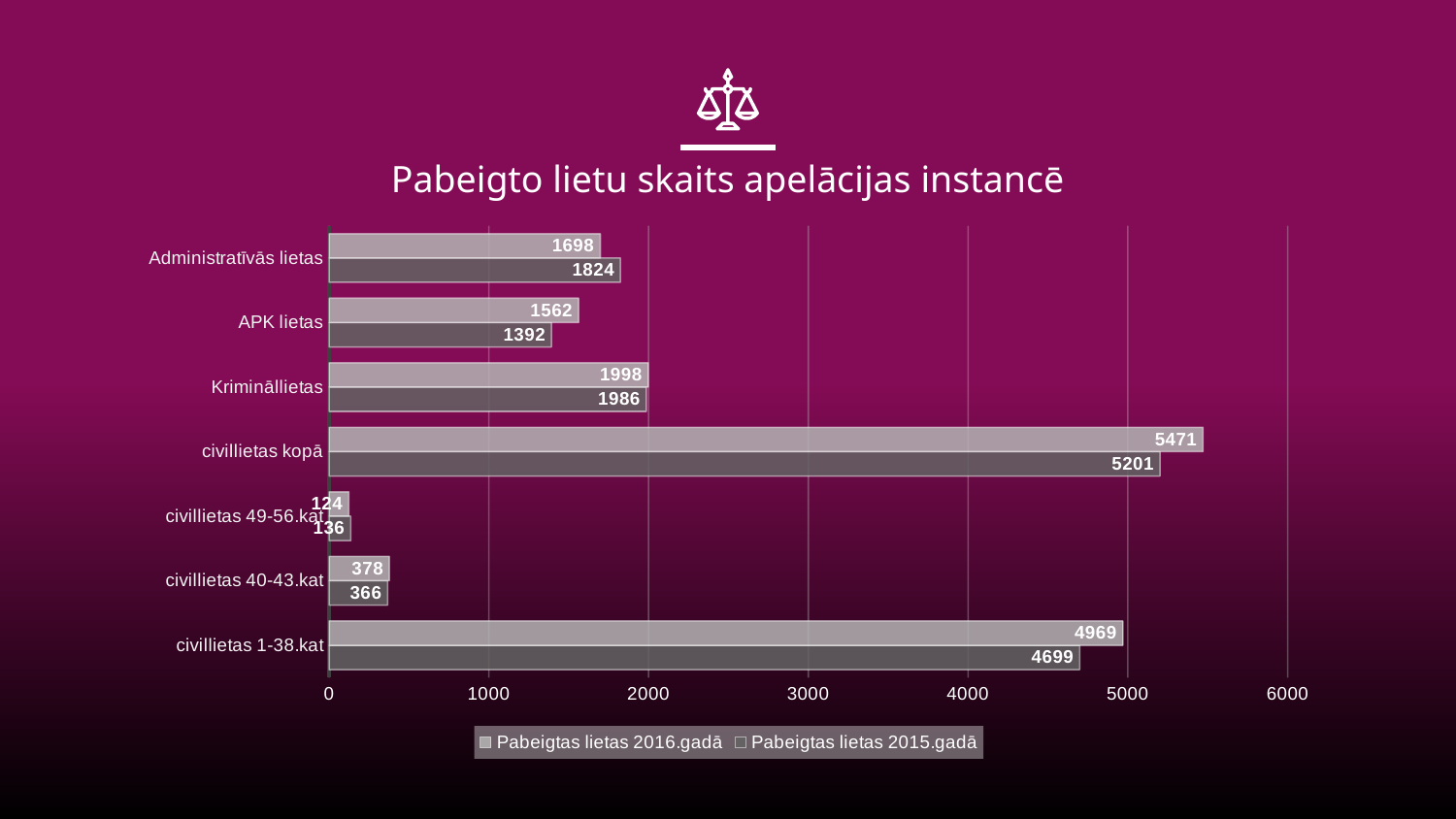
Which category has the highest value in the series Pabeigtas lietas 2015.gadā? civillietas kopā What is the value for APK lietas in the series Pabeigtas lietas 2016.gadā? 1392 What is the value for civillietas kopā in the series Pabeigtas lietas 2016.gadā? 5201 How many categories are shown on the chart? 7 What is the value for Administratīvās lietas in the series Pabeigtas lietas 2015.gadā? 1698 For Krimināllietas, which series has the larger value: Pabeigtas lietas 2016.gadā or Pabeigtas lietas 2015.gadā? Pabeigtas lietas 2015.gadā Which category has the lowest value in the series Pabeigtas lietas 2016.gadā? civillietas 49-56.kat What is the difference between the 2015 and 2016 values for civillietas 1-38.kat? 270 What is the title of the chart? Pabeigto lietu skaits apelācijas instancē What kind of chart is shown on the slide? bar chart Is the value for civillietas 40-43.kat in the series Pabeigtas lietas 2016.gadā greater or less than 1000? less How many series does the legend list? 2